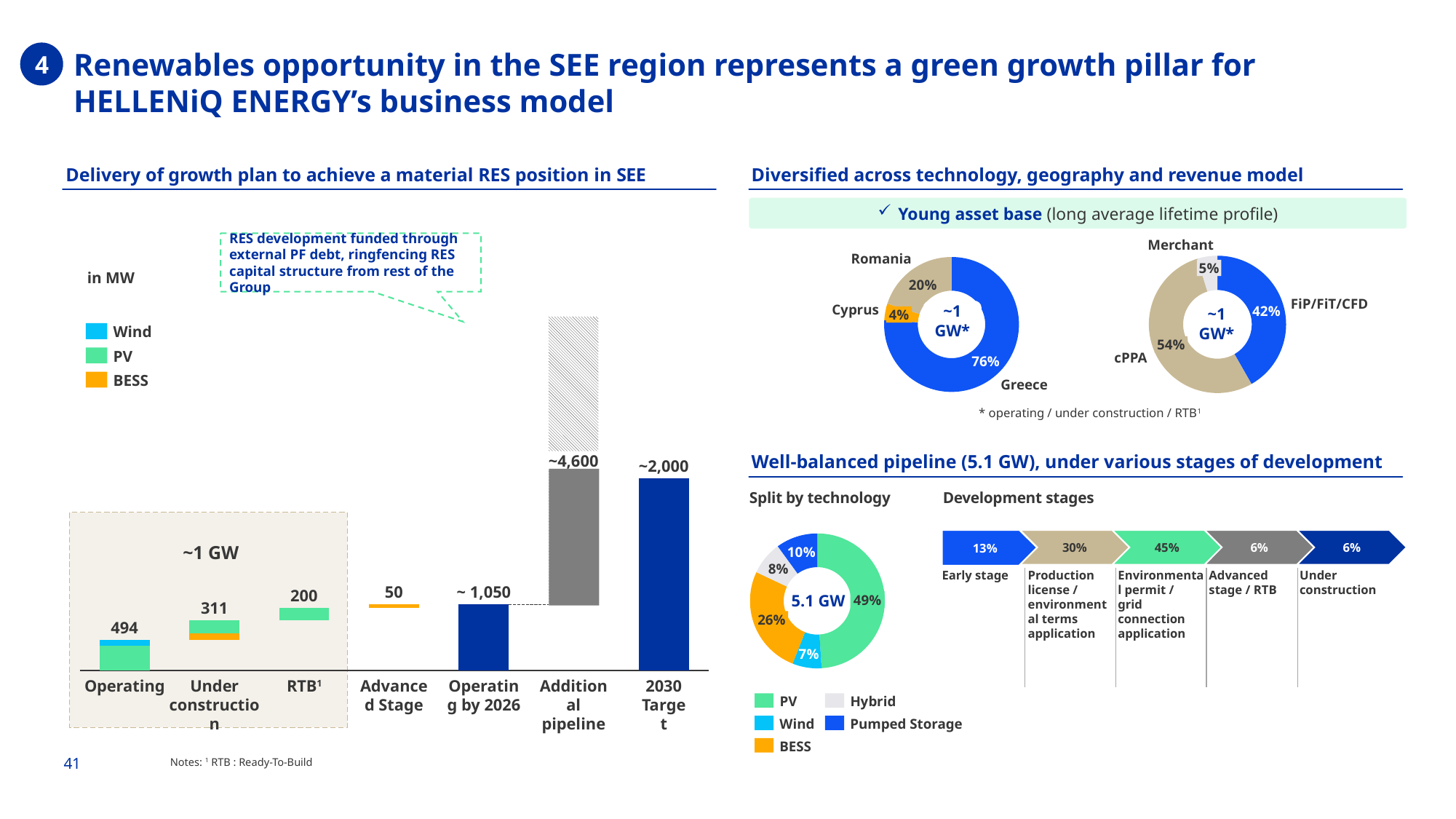
How many series does the legend of the bar chart on the left list? 3 In the 'Development stages' chart, what percentage is shown for the Environmental permit / grid connection application stage? 45% In the bar chart on the left (in MW), what is the value for Under construction? 311 In the geography donut chart (top right, left donut), which country has the smallest share? Cyprus In the bar chart on the left (in MW), what is the value for Operating? 494 In the 'Split by technology' donut chart, which technology has the largest share? PV In the revenue model donut chart (top right, right donut), what is the difference between the cPPA share and the FiP/FiT/CFD share? 12% In the bar chart on the left (in MW), what is the value for the 2030 Target? ~2,000 In the bar chart on the left (in MW), what is the difference between the Operating value and the RTB value? 294 In the geography donut chart (top right, left donut), what share does Greece represent? 76% In the revenue model donut chart (top right, right donut), what share does cPPA represent? 54% In the bar chart on the left (in MW), which is larger, Under construction or Advanced Stage? Under construction